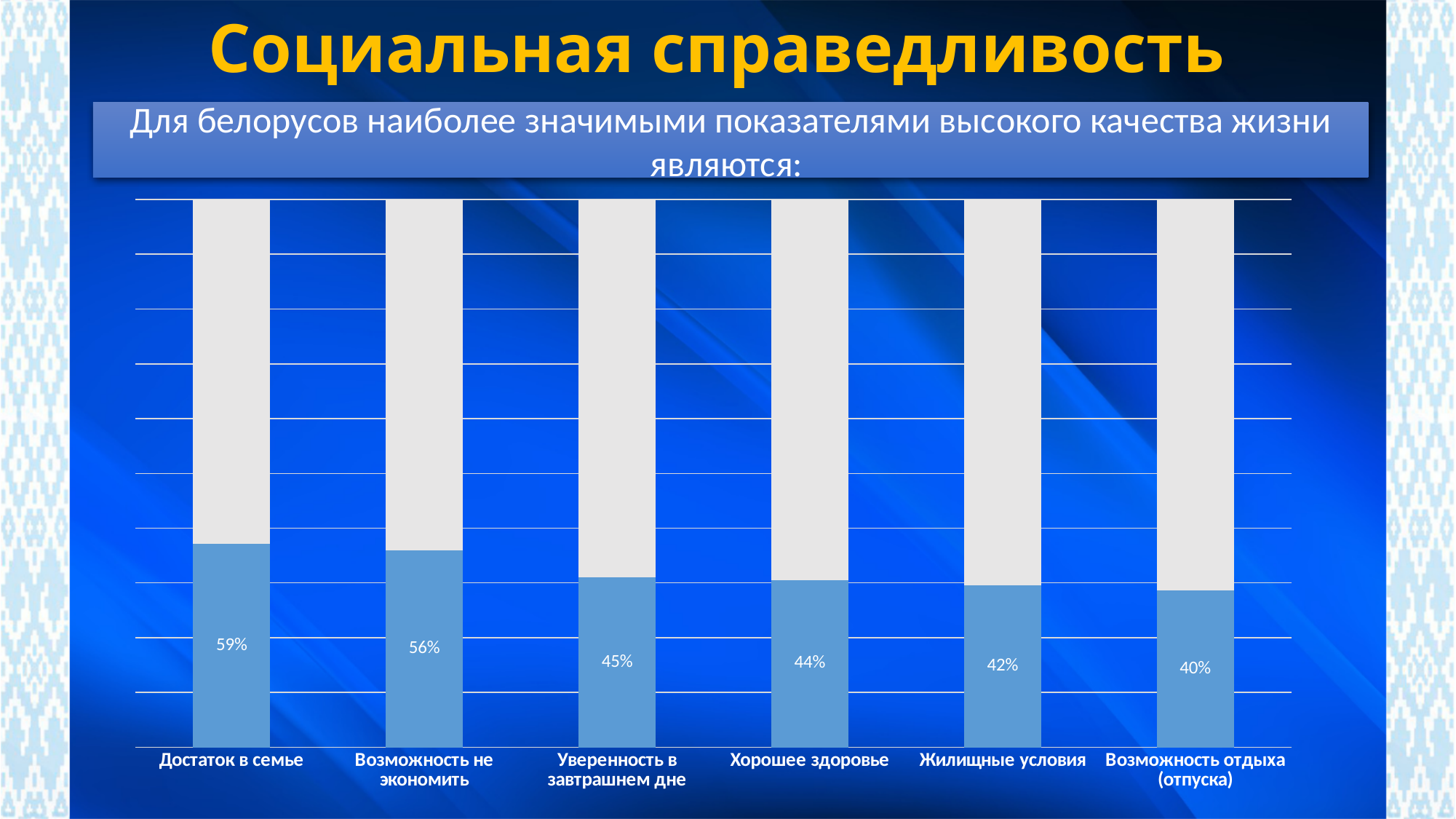
What is the value shown for «Возможность отдыха (отпуска)»? 40% What is the value shown for «Уверенность в завтрашнем дне»? 45% How many categories are shown on the chart? 6 Which category has the highest value? Достаток в семье What is the difference between the values for «Достаток в семье» and «Жилищные условия»? 17% What is the value shown for «Хорошее здоровье»? 44% Do the labelled values rise or fall from left to right across the categories? Fall What is the value shown for «Достаток в семье»? 59% Which is larger: the value for «Возможность не экономить» or the value for «Хорошее здоровье»? Возможность не экономить What kind of chart is shown on the slide? Bar chart What is the value shown for «Возможность не экономить»? 56% Which category has the lowest value? Возможность отдыха (отпуска)